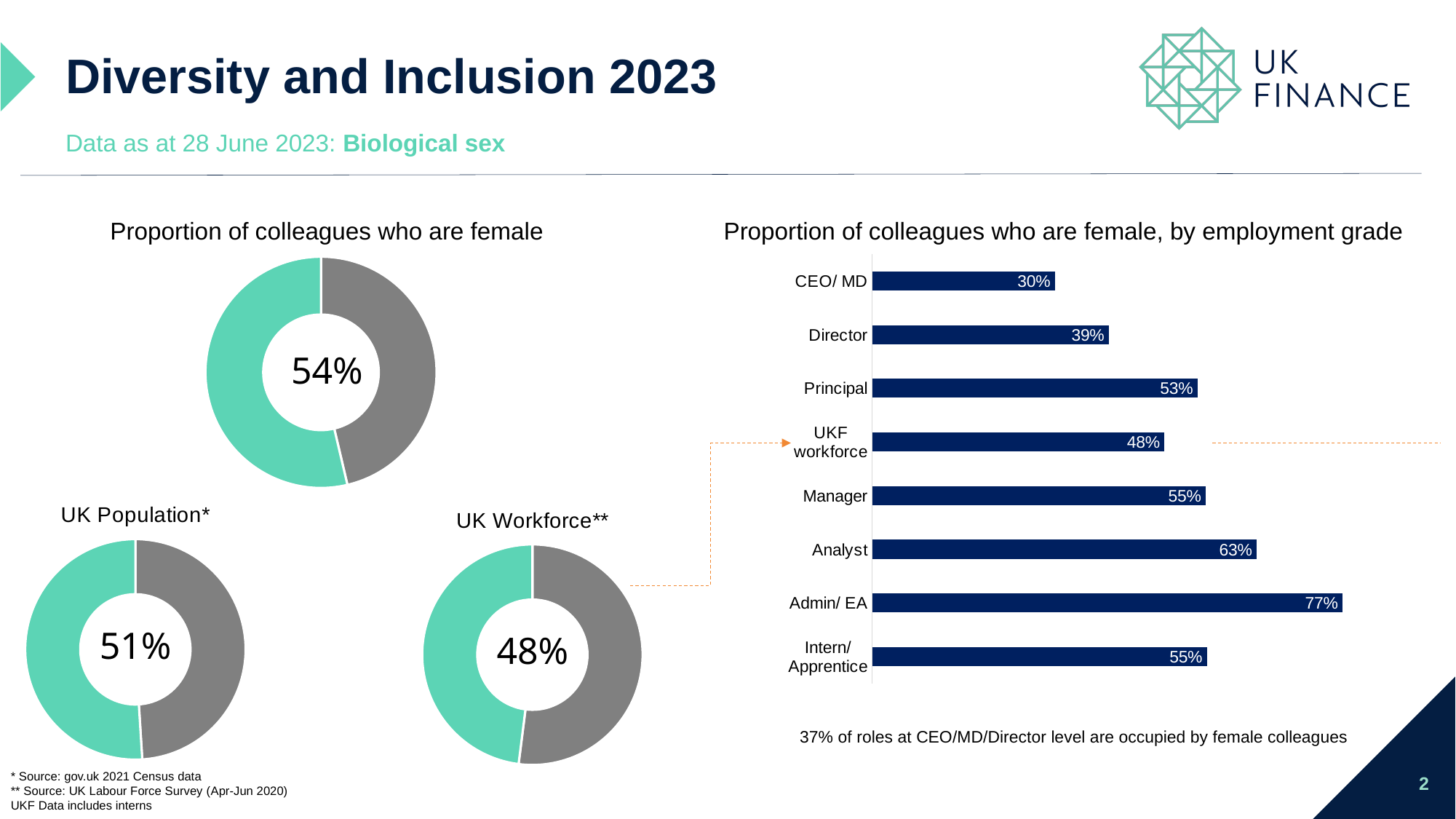
In the 'Proportion of colleagues who are female, by employment grade' chart, what is the value for Analyst? 63% How many employment grades are shown in the 'Proportion of colleagues who are female, by employment grade' chart? 8 What is the difference between the value in the 'UK Population*' donut chart and the value in the 'UK Workforce**' donut chart? 3% In the 'Proportion of colleagues who are female, by employment grade' chart, what is the value for CEO/ MD? 30% In the 'Proportion of colleagues who are female, by employment grade' chart, which employment grade has the lowest value? CEO/ MD In the 'UK Workforce**' donut chart, what is the value shown? 48% What kind of chart is the 'Proportion of colleagues who are female, by employment grade' chart? Bar chart In the 'UK Population*' donut chart, what is the value shown? 51% In the 'Proportion of colleagues who are female, by employment grade' chart, which is larger, the value for Principal or the value for Manager? Manager In the 'Proportion of colleagues who are female' donut chart at the top left, what proportion of colleagues are female? 54% In the 'Proportion of colleagues who are female, by employment grade' chart, what is the difference between the Admin/ EA value and the Director value? 38% In the 'Proportion of colleagues who are female, by employment grade' chart, which employment grade has the highest value? Admin/ EA